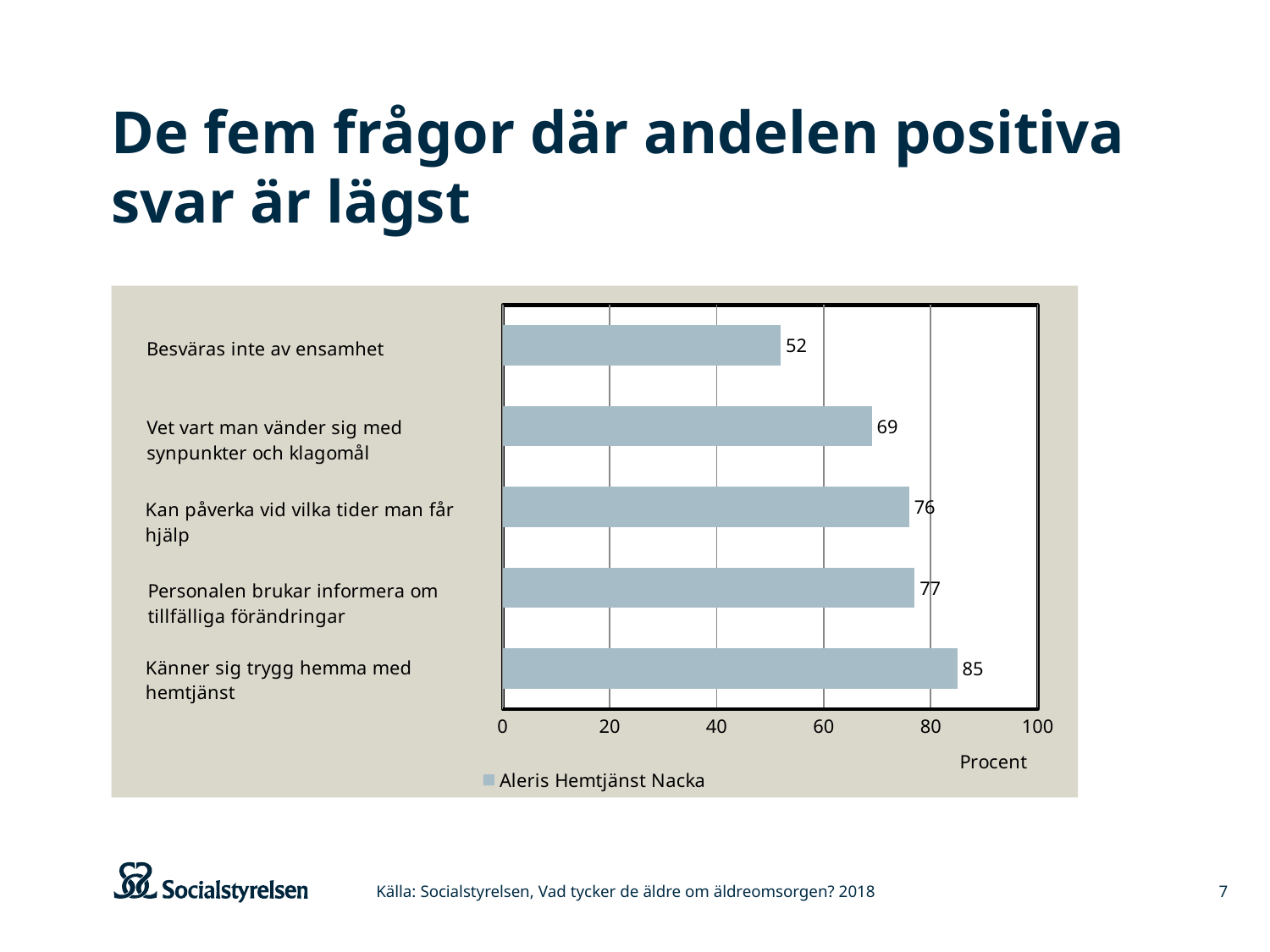
Which category has the lowest value? Besväras inte av ensamhet How many series does the legend list? 1 How many categories are shown in the chart? 5 What is the value for "Besväras inte av ensamhet"? 52 Is the value for "Vet vart man vänder sig med synpunkter och klagomål" greater or less than 60? greater What is the value for "Känner sig trygg hemma med hemtjänst"? 85 What is the difference between the values for "Känner sig trygg hemma med hemtjänst" and "Besväras inte av ensamhet"? 33 Which category has the highest value? Känner sig trygg hemma med hemtjänst What is the value for "Kan påverka vid vilka tider man får hjälp"? 76 What series name is shown in the legend? Aleris Hemtjänst Nacka What kind of chart is shown on the slide? Bar chart Which is larger: the value for "Vet vart man vänder sig med synpunkter och klagomål" or the value for "Kan påverka vid vilka tider man får hjälp"? Kan påverka vid vilka tider man får hjälp